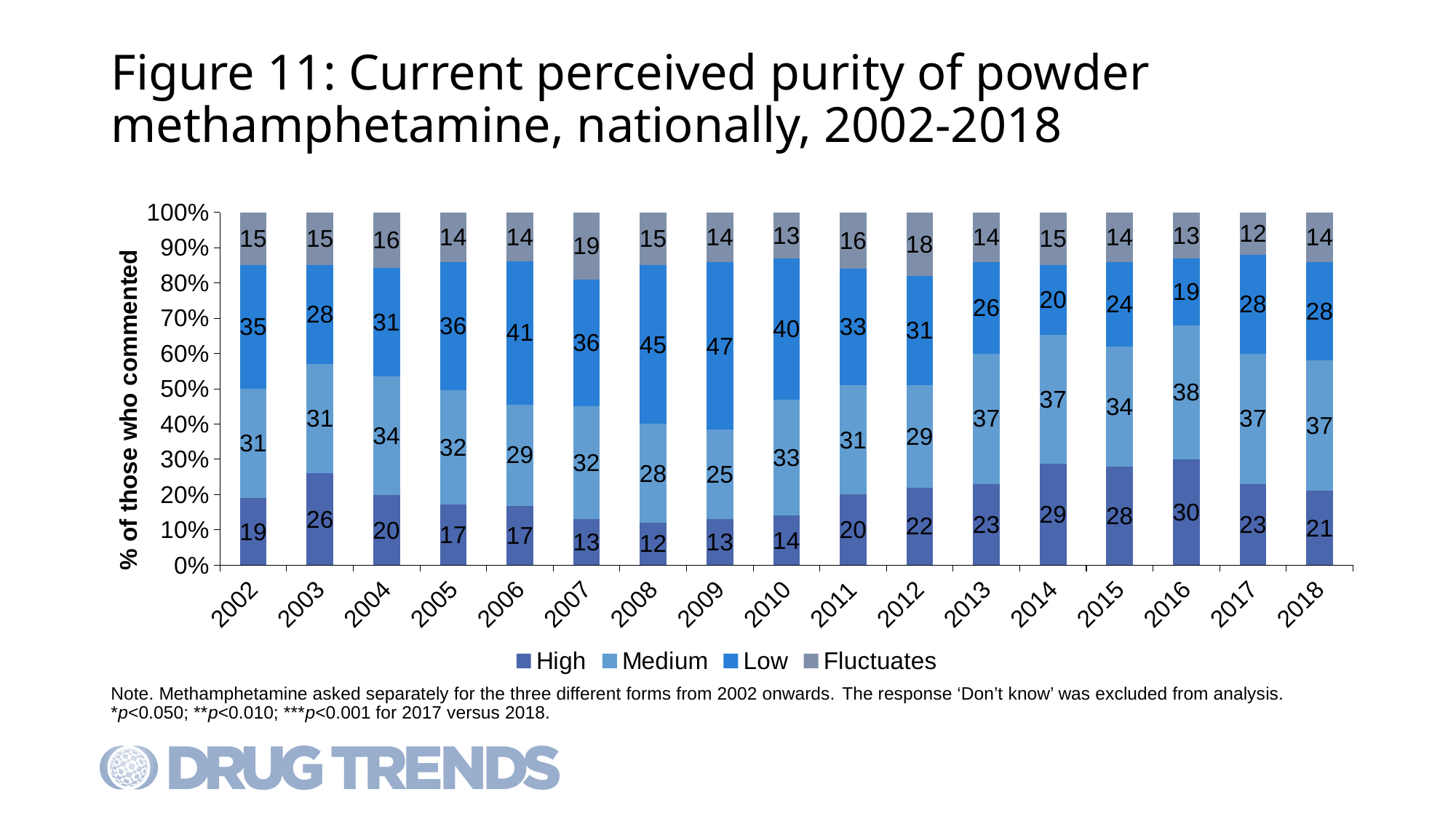
How many series does the legend list? 4 What is the 'Medium' value for 2018? 37 How many years are shown on the x axis? 17 What is the difference between the 'Low' value in 2009 and the 'Low' value in 2016? 28 In which year is the 'High' segment the largest? 2016 Which is larger: the 'High' value in 2003 or the 'High' value in 2004? 2003 What is the 'Low' value for 2009? 47 In which year is the 'Low' segment the largest? 2009 What is the 'Fluctuates' value for 2007? 19 In which year is the 'High' segment the smallest? 2008 What percentage of respondents rated powder methamphetamine purity as 'High' in 2016? 30 What kind of chart is shown on the slide? Stacked bar chart